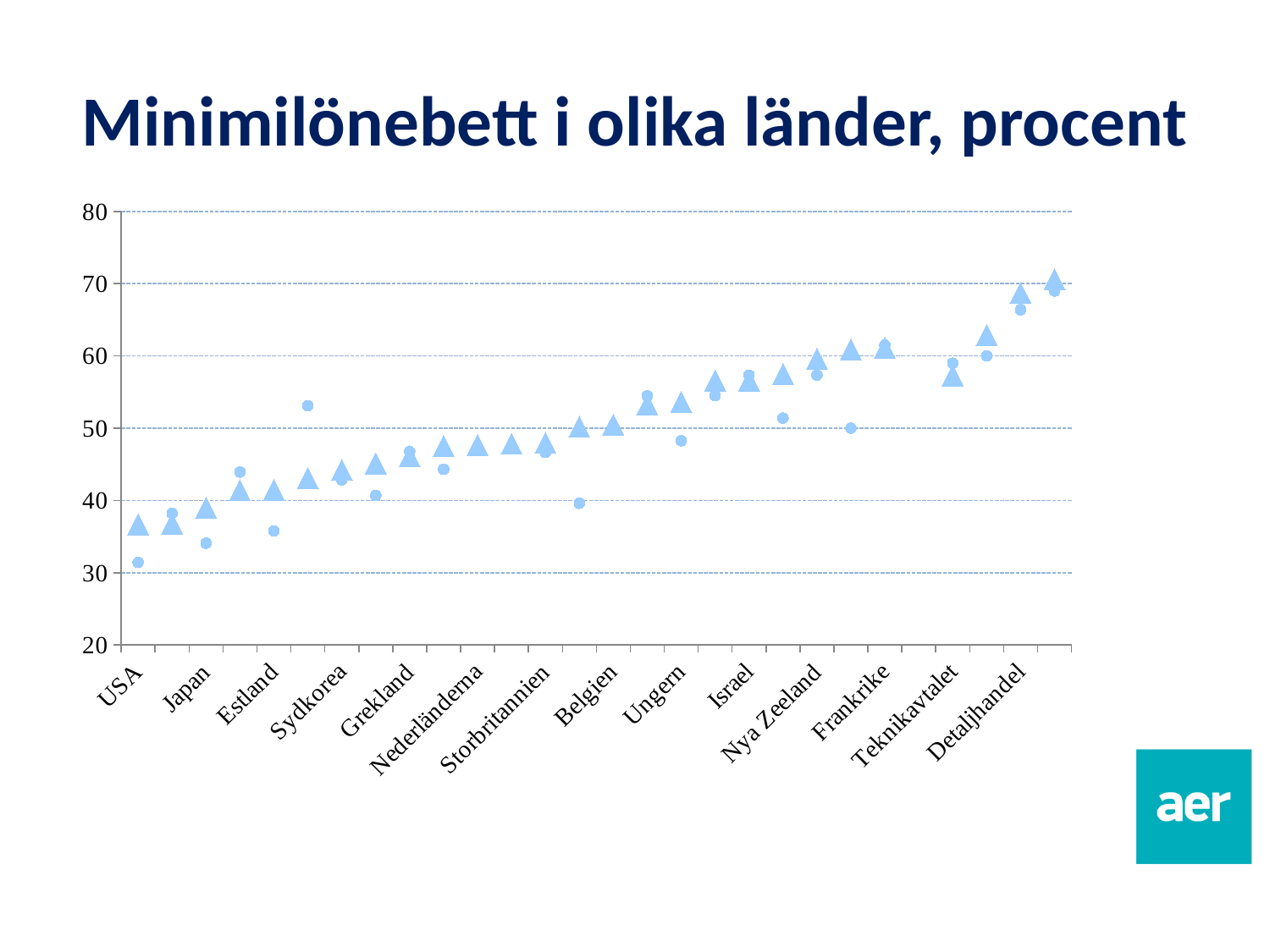
How many category labels are shown on the x axis? 14 Is the triangle-marker value for Teknikavtalet greater or less than 60? less Is the triangle-marker value for USA greater or less than 40? less Is the circle-marker value for Israel greater or less than 50? greater Which labelled category has the lowest plotted values? USA Do the plotted values generally rise or fall from left to right along the x axis? rise Which labelled category has the highest plotted values? Detaljhandel What is the title of the chart? Minimilönebett i olika länder, procent What kind of chart is shown on the slide? scatter chart